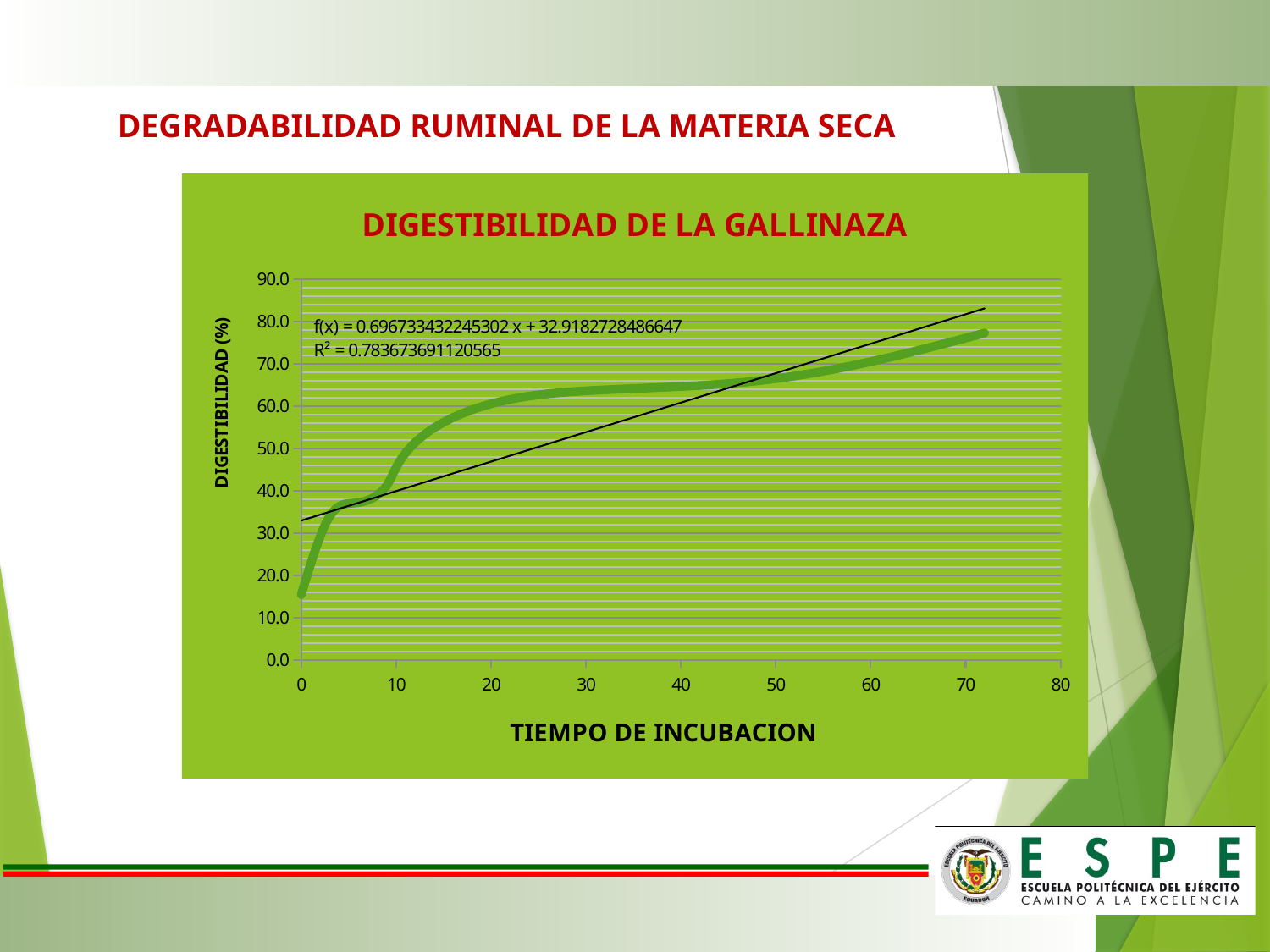
What is the title of the chart? DIGESTIBILIDAD DE LA GALLINAZA What is the label of the y axis of the chart? DIGESTIBILIDAD (%) Is the digestibility value at the last plotted point (around incubation time 72) greater or less than 70? greater What kind of chart is shown on the slide? line chart Is the digestibility value at incubation time 48 greater or less than 60? greater What is the trendline equation printed on the chart? f(x) = 0.696733432245302 x + 32.9182728486647 What is the highest value shown on the y axis of the chart? 90.0 Is the digestibility value at incubation time 10 greater or less than 30? greater What is the R² value printed on the chart for the trendline? 0.783673691120565 Do the plotted digestibility values rise or fall as incubation time increases along the x axis? rise